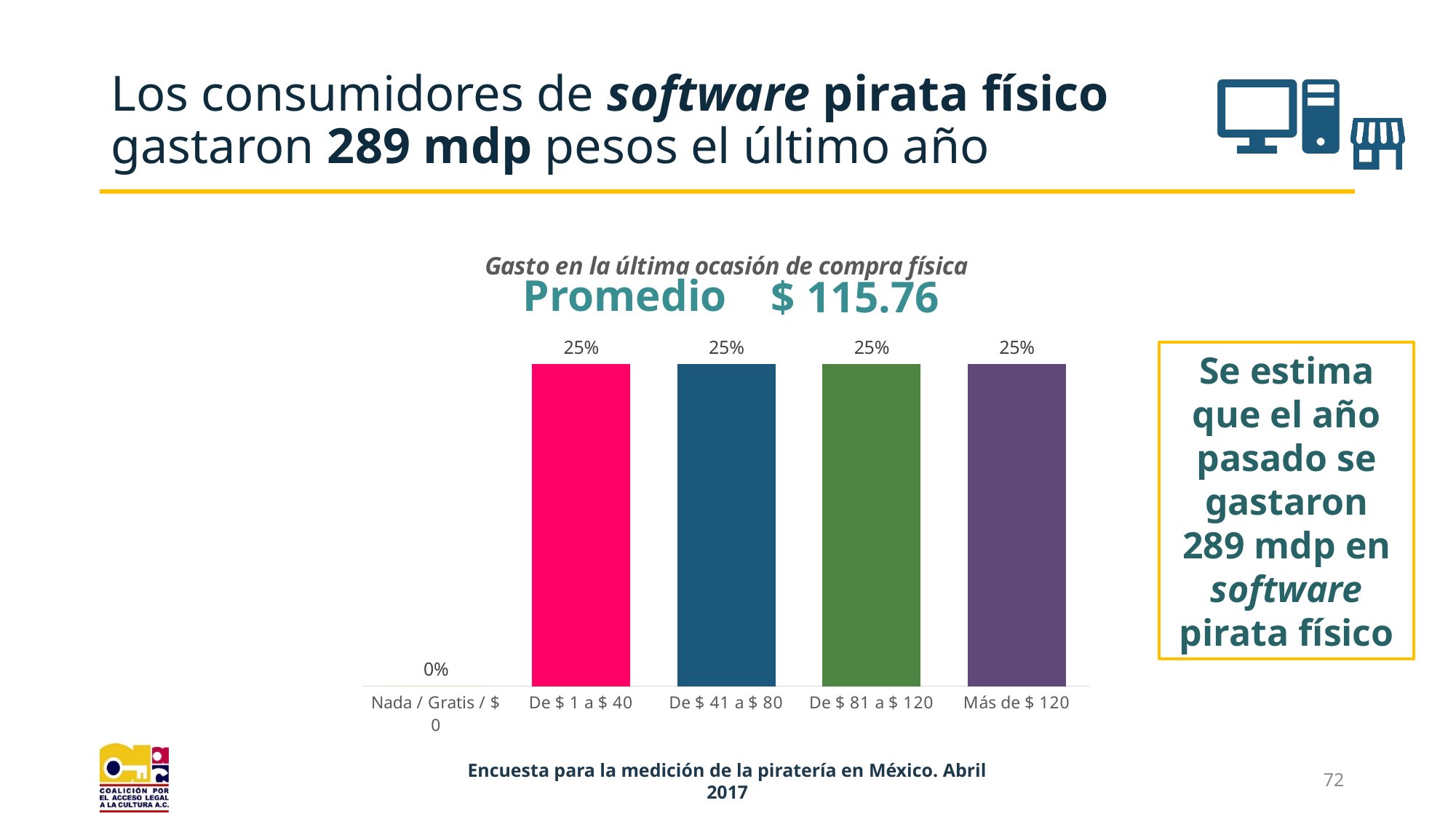
Which category has the lowest value? Nada / Gratis / $ 0 What type of chart is shown on the slide? bar chart What average (Promedio) value is shown above the chart? $ 115.76 What is the difference between the value for 'Más de $ 120' and the value for 'Nada / Gratis / $ 0'? 25% What is the value for the category 'De $ 81 a $ 120'? 25% Which is larger, the value for 'De $ 41 a $ 80' or the value for 'Nada / Gratis / $ 0'? De $ 41 a $ 80 What is the value for the category 'De $ 1 a $ 40'? 25% What is the value for the category 'Más de $ 120'? 25% What is the title of the chart? Gasto en la última ocasión de compra física How many categories have a value of 25%? 4 How many categories are shown on the x axis of the chart? 5 What is the value for the category 'Nada / Gratis / $ 0'? 0%